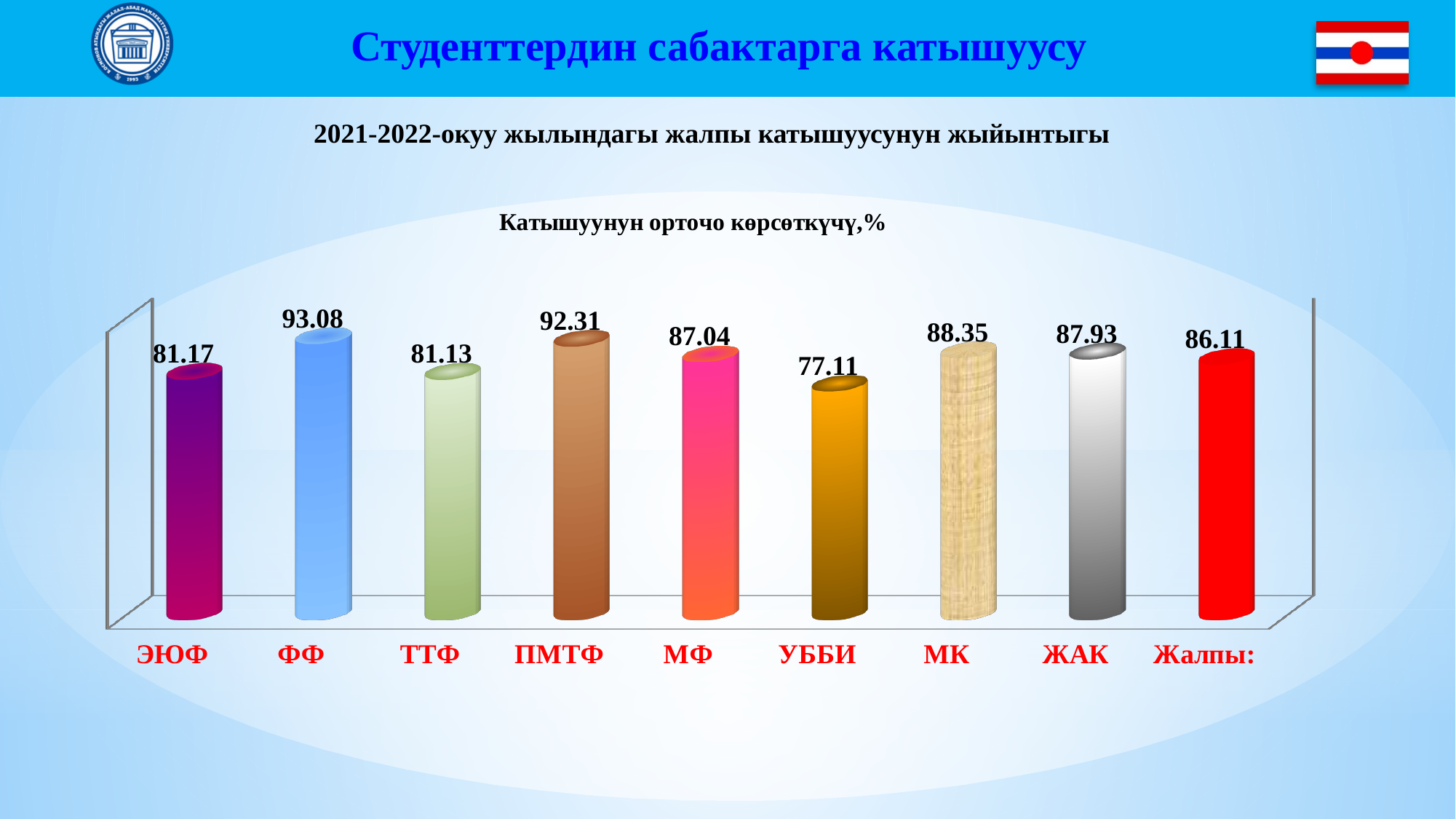
What is the difference between the values for ПМТФ and МФ? 5.27 What is the value for Жалпы:? 86.11 What kind of chart is shown on the slide? Bar chart Which category has the lowest value? УББИ What is the difference between the values for ФФ and УББИ? 15.97 How many categories are shown on the x axis? 9 What is the title of the chart? Катышуунун орточо көрсөткүчү,% Which category has the highest value? ФФ What is the value for УББИ? 77.11 What is the value for МК? 88.35 Which is larger, the value for ПМТФ or the value for ЖАК? ПМТФ What is the value for ФФ? 93.08